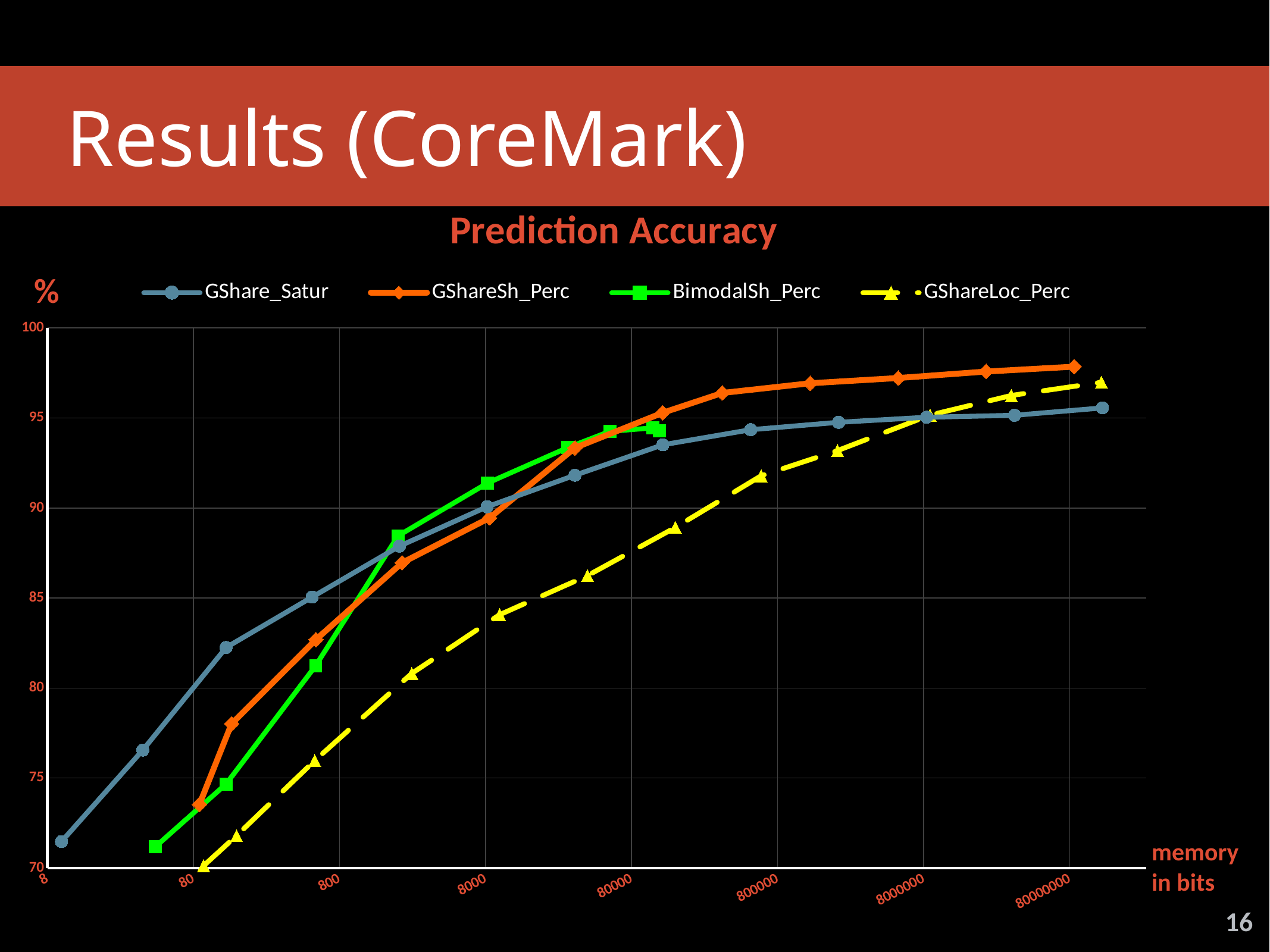
Do the values of the GShare_Satur series rise or fall as memory in bits increases? rise Is the value for GShareLoc_Perc at 80000 bits greater or less than 90? less What kind of chart is shown on the slide? line chart How many series does the legend list? 4 Is the value for GShareSh_Perc at 80000000 bits greater or less than 95? greater Is the value for GShare_Satur at 8 bits greater or less than 75? less What is the title of the chart? Prediction Accuracy Which series has the lowest value at 80000 bits? GShareLoc_Perc At 800 bits, which series has the higher value, GShare_Satur or GShareLoc_Perc? GShare_Satur What is the label of the x axis? memory in bits At 80000000 bits, which series has the higher value, GShareSh_Perc or GShare_Satur? GShareSh_Perc